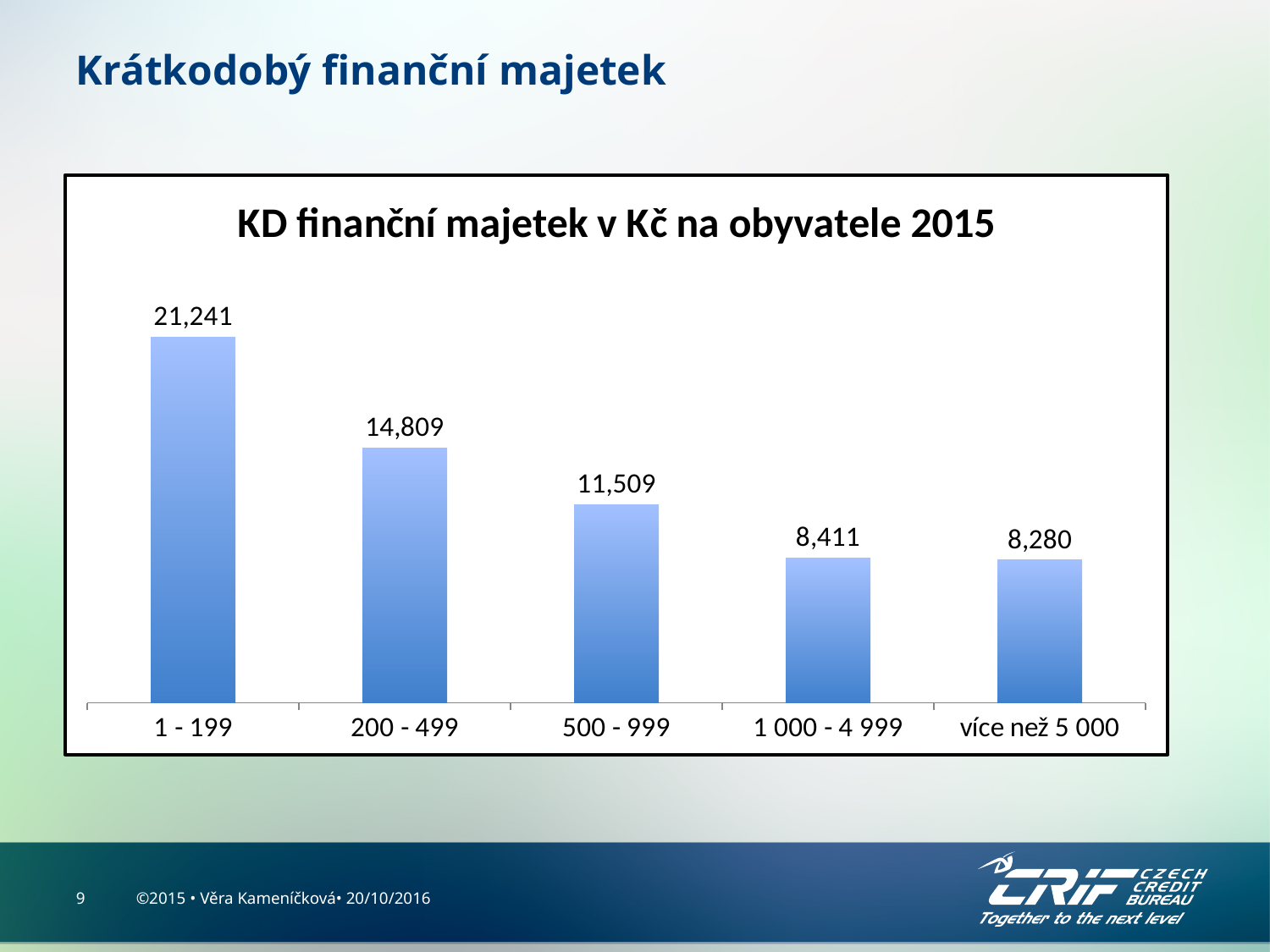
What is the value for the "500 - 999" category? 11,509 What is the value for the "více než 5 000" category? 8,280 Which category has the lowest value? více než 5 000 What is the value for the "1 - 199" category? 21,241 What is the title of the chart? KD finanční majetek v Kč na obyvatele 2015 How many categories are shown on the x axis? 5 Which category has the highest value? 1 - 199 What is the difference between the values for "1 000 - 4 999" and "více než 5 000"? 131 Which is larger, the value for "200 - 499" or the value for "500 - 999"? 200 - 499 What is the difference between the values for "1 - 199" and "200 - 499"? 6,432 What kind of chart is shown on the slide? bar chart Do the values rise or fall from left to right along the x axis? fall